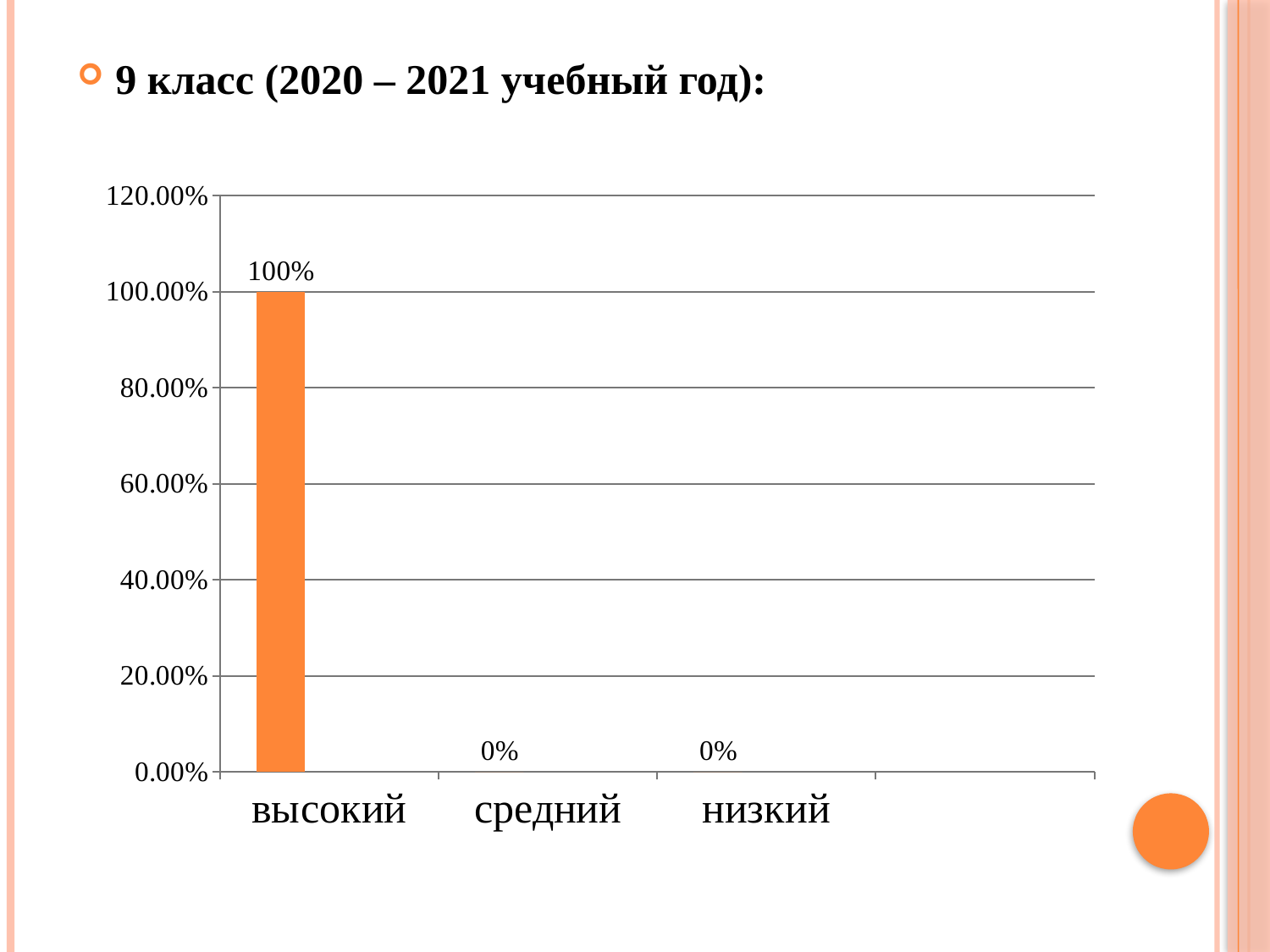
Which category has the highest value? высокий What is the value for низкий? 0% Do the values rise or fall from высокий to низкий along the x axis? fall What is the difference between the values for высокий and средний? 100% What is the value for средний? 0% What colour is the bar for высокий? orange What kind of chart is shown on the slide? bar chart How many categories are shown on the x axis? 3 What is the highest tick value shown on the vertical axis? 120.00% What is the value for высокий? 100% Is the value for высокий greater or less than 80.00%? greater Which is larger, the value for высокий or the value for низкий? высокий